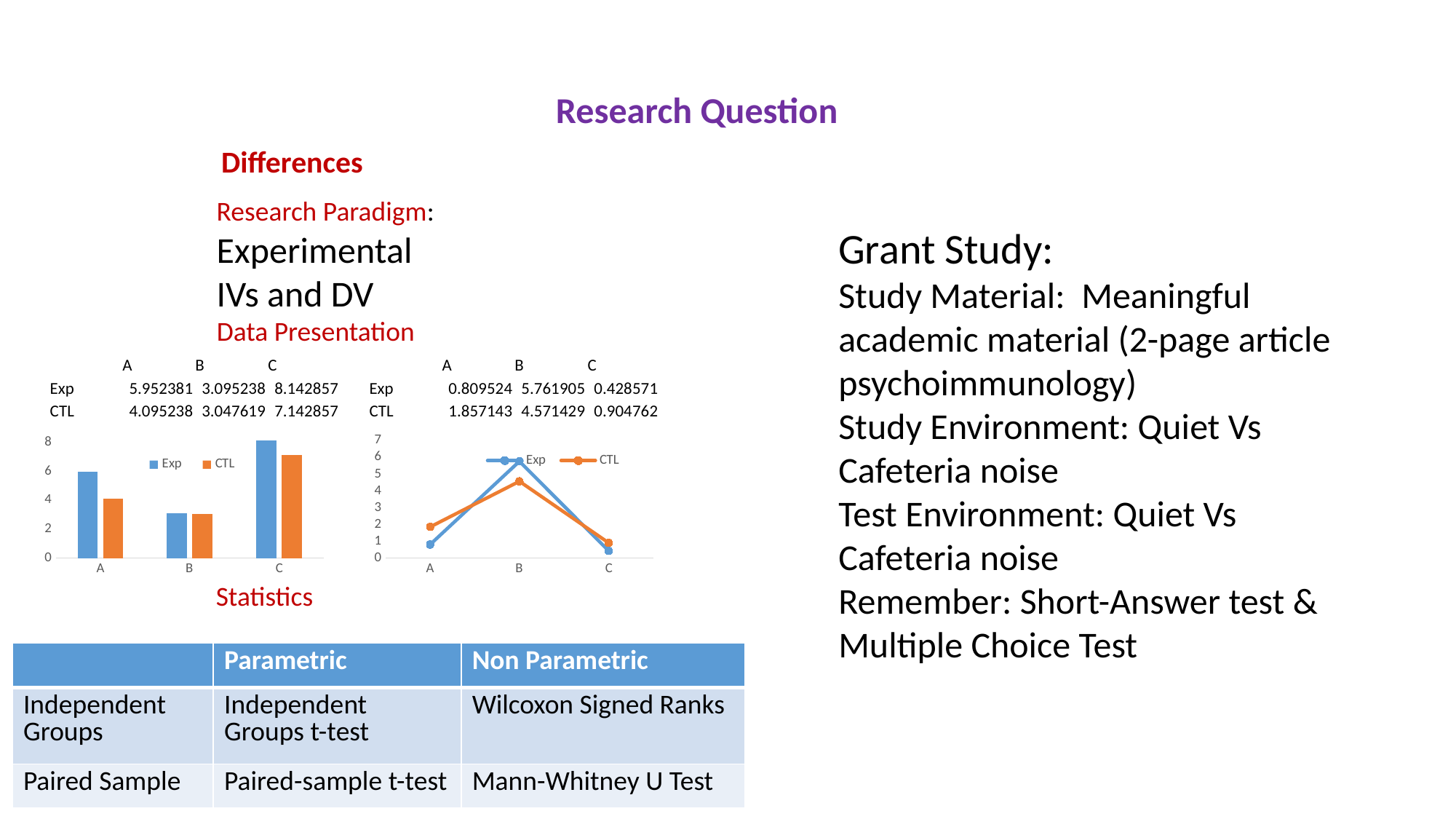
In the right line chart, which category has the lowest CTL value? C In the left bar chart, what is the difference between the Exp and CTL values for category C? 1 What type of chart is the right chart on the slide? line chart What type of chart is the left chart on the slide? bar chart In the left bar chart, what is the Exp value for category C? 8.142857 How many series does the legend of the left bar chart list? 2 In the right line chart, what is the CTL value for category C? 0.904762 In the left bar chart, what is the CTL value for category A? 4.095238 In the left bar chart, which category has the highest Exp value? C How many categories are shown on the x axis of the right line chart? 3 In the right line chart, what is the Exp value for category B? 5.761905 In the right line chart, which is larger for category A, Exp or CTL? CTL